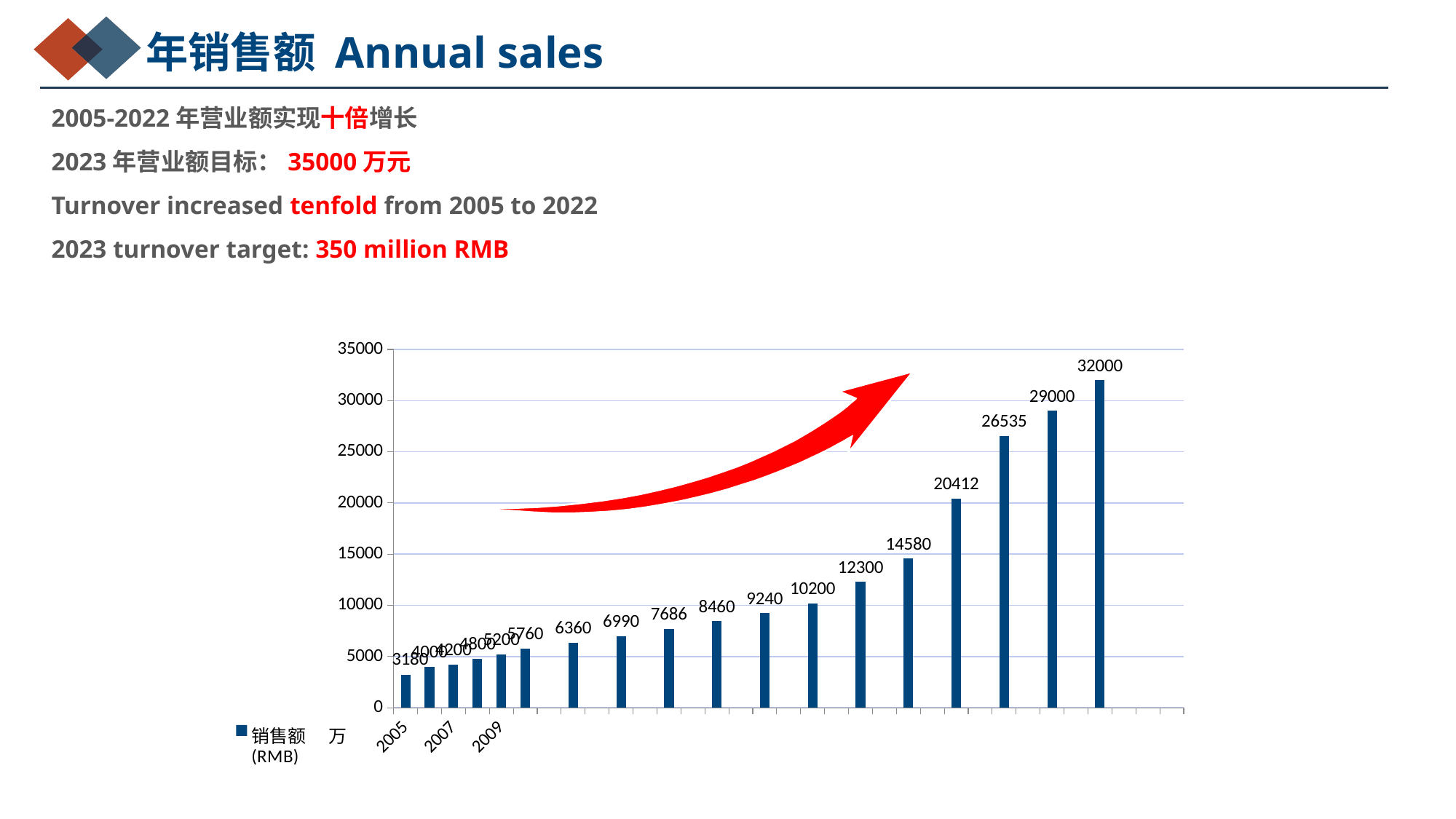
What is the difference between the two tallest bars (32000 and 29000)? 3000 What is the value of the shortest bar in the chart? 3180 What type of chart is shown on the slide? bar chart What is the sales value for 2005? 3180 How many series does the legend list? 1 Is the value for 2007 greater or less than 5000? less How many bars are plotted in the chart? 18 Do the values generally rise or fall from left to right along the x axis? rise What is the difference between the bars labelled 26535 and 20412? 6123 What is the value of the tallest bar in the chart? 32000 What is the value of the second-tallest bar in the chart? 29000 What is the highest value shown on the vertical axis? 35000